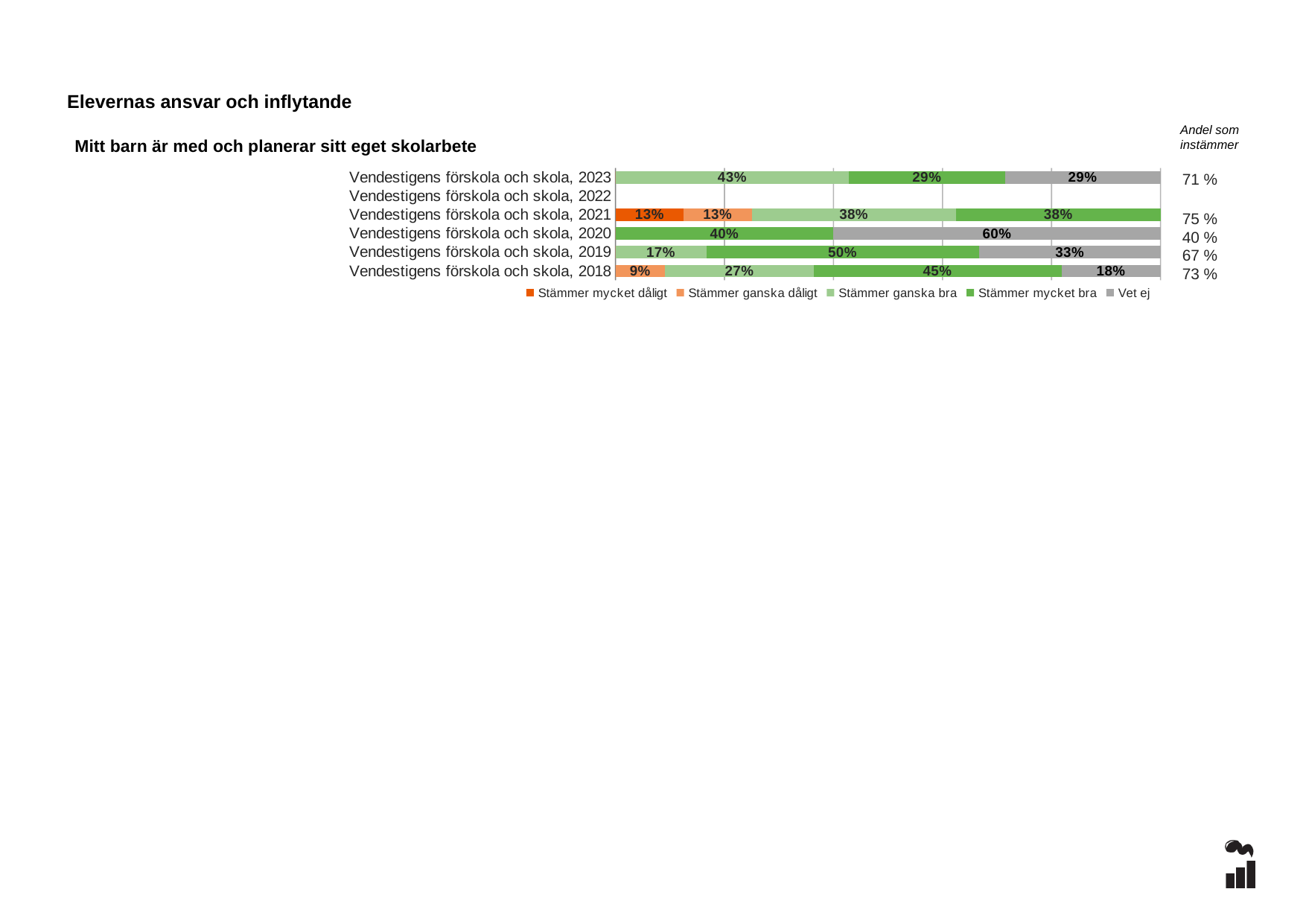
What is the difference between the "Stämmer mycket bra" values for 2019 and 2020? 10% What is the value for "Stämmer mycket dåligt" for Vendestigens förskola och skola, 2021? 13% What kind of chart is shown on the slide? stacked bar chart Which year has the highest value for "Stämmer mycket bra"? Vendestigens förskola och skola, 2019 Which year has the lowest value for "Vet ej" among the years where it is shown? Vendestigens förskola och skola, 2018 What is the value for "Vet ej" for Vendestigens förskola och skola, 2020? 60% What is the "Andel som instämmer" value shown for Vendestigens förskola och skola, 2021? 75 % What is the value for "Stämmer ganska dåligt" for Vendestigens förskola och skola, 2018? 9% What is the value for "Stämmer ganska bra" for Vendestigens förskola och skola, 2023? 43% What is the title of the chart? Mitt barn är med och planerar sitt eget skolarbete Which is larger: "Stämmer ganska bra" for 2023 or "Stämmer ganska bra" for 2018? Vendestigens förskola och skola, 2023 How many series does the legend list? 5